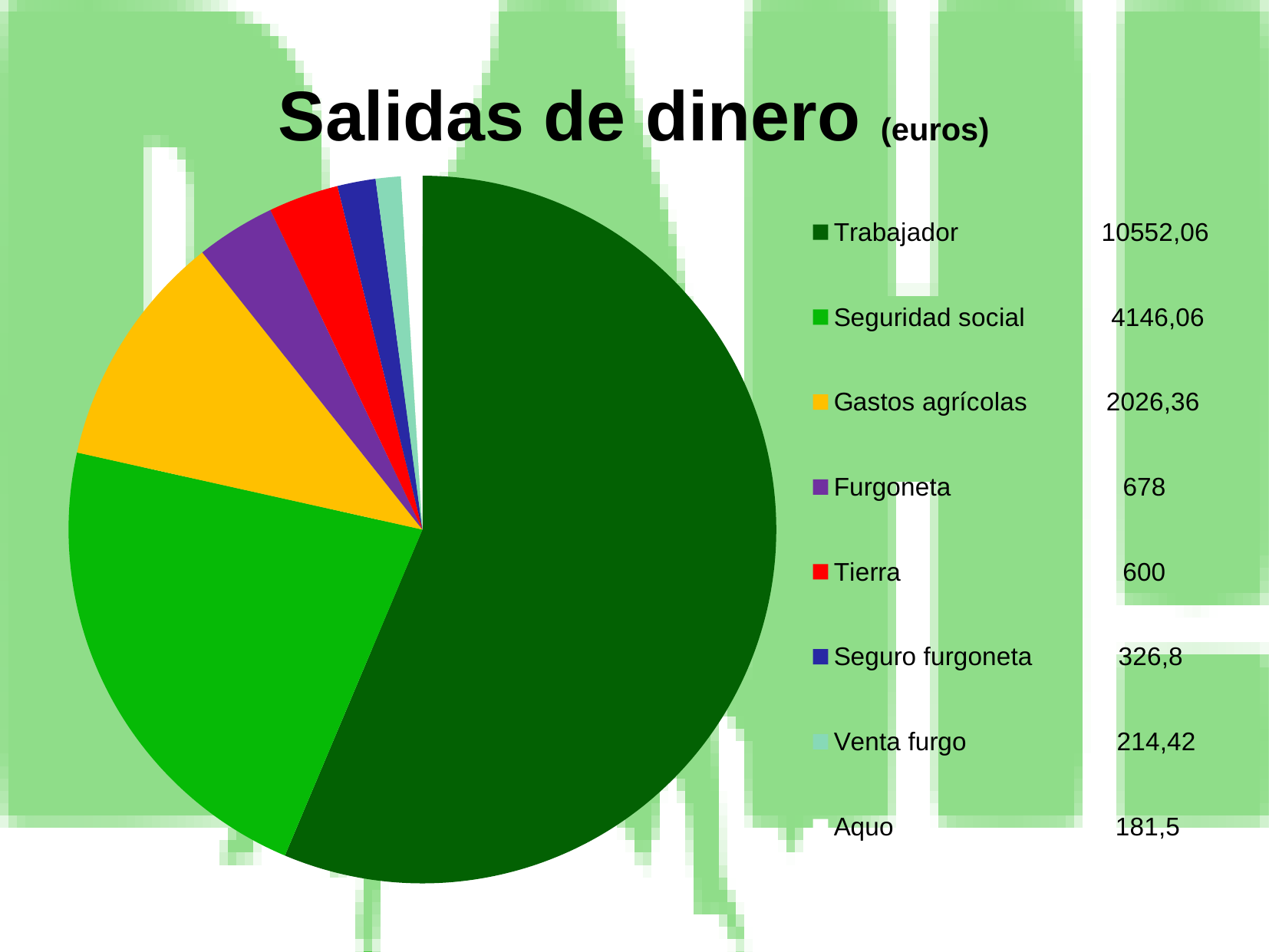
What kind of chart is shown on the slide? pie chart Which is larger, Furgoneta or Tierra? Furgoneta What is the title of the chart? Salidas de dinero (euros) What is the value for Trabajador? 10552,06 Which category has the largest slice of the pie? Trabajador What is the value for Seguridad social? 4146,06 What is the value for Gastos agrícolas? 2026,36 Which category has the smallest value? Aquo What is the value for Seguro furgoneta? 326,8 What colour is the slice for Gastos agrícolas? yellow How many categories does the pie chart have? 8 What is the difference between the values for Trabajador and Seguridad social? 6406